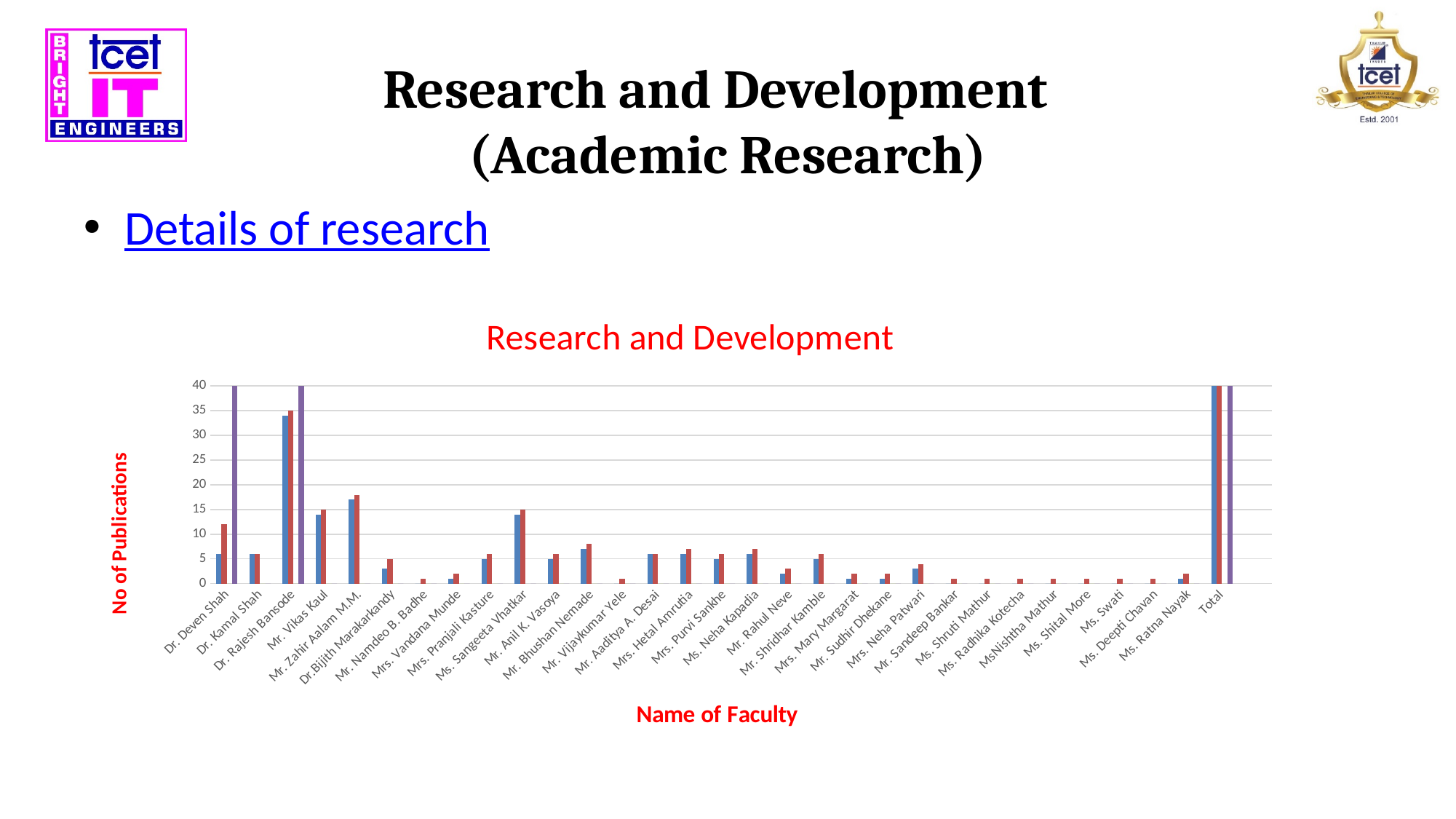
Is the value of the red bar for Mr. Zahir Aalam M.M. greater or less than 15? greater Excluding the Total category, which faculty member has the highest bars in the chart? Dr. Rajesh Bansode Is the value of the red bar for Dr. Deven Shah greater or less than 10? greater What kind of chart is shown on the slide? bar chart What is the label on the vertical axis of the chart? No of Publications What is the highest value shown on the vertical axis of the chart? 40 Is the value of the blue bar for Dr. Rajesh Bansode greater or less than 30? greater What is the title of the chart? Research and Development Which has the larger blue bar, Dr. Rajesh Bansode or Mr. Zahir Aalam M.M.? Dr. Rajesh Bansode Which has the larger red bar, Dr. Deven Shah or Dr. Kamal Shah? Dr. Deven Shah